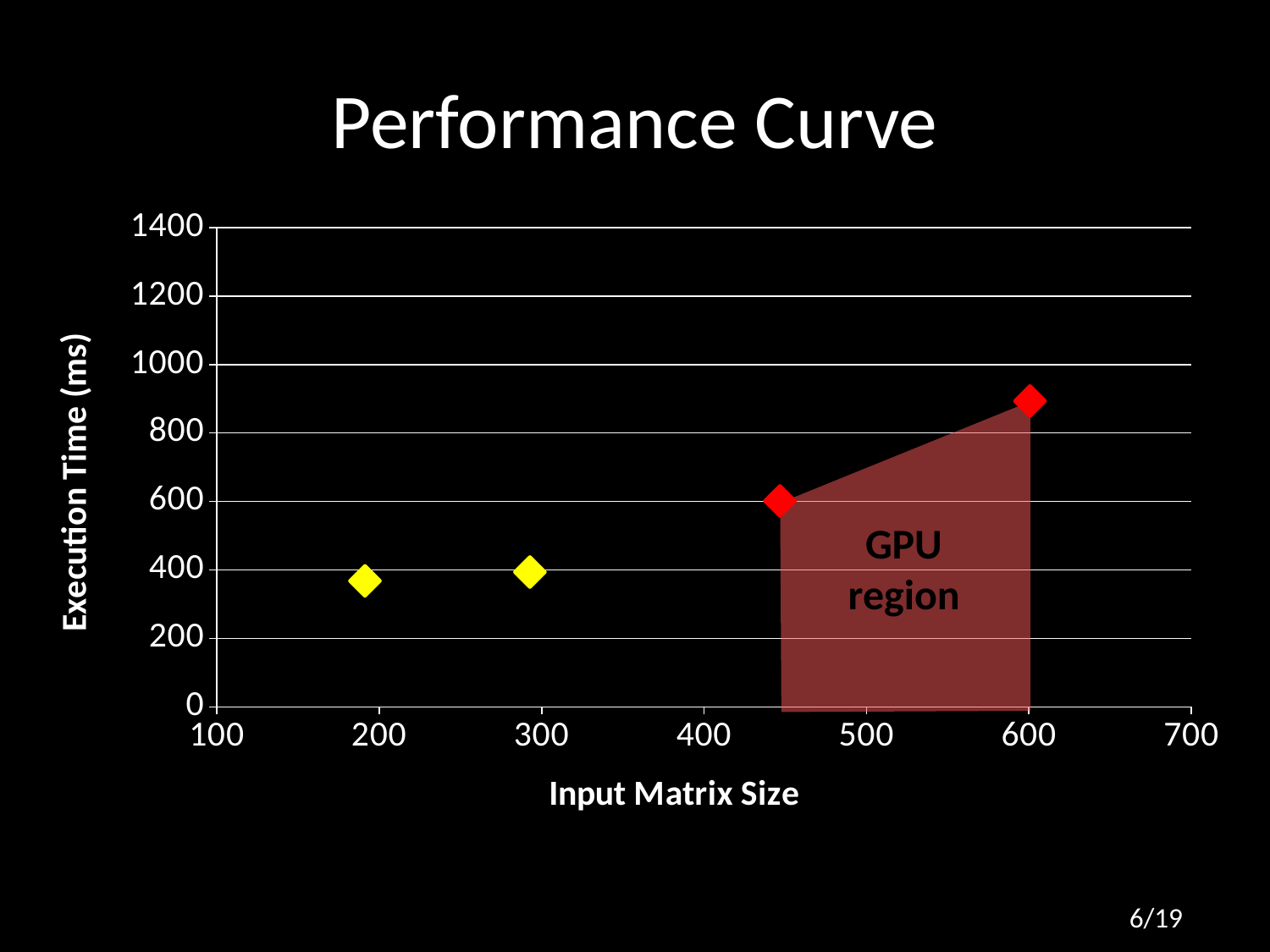
Is the execution time for the point near input matrix size 300 greater or less than 200? greater How many yellow data points are plotted on the chart? 2 Does execution time rise or fall as input matrix size increases? rise At which input matrix size is the execution time highest? 600 What kind of chart is shown on the slide? scatter chart Is the execution time for the point at input matrix size 600 greater or less than 1000? less Is the execution time for the point near input matrix size 200 greater or less than 600? less What is the label of the shaded area on the chart? GPU region How many red data points are plotted on the chart? 2 Which has the larger execution time: the point at input matrix size 450 or the point at input matrix size 600? 600 How many data points are plotted on the chart? 4